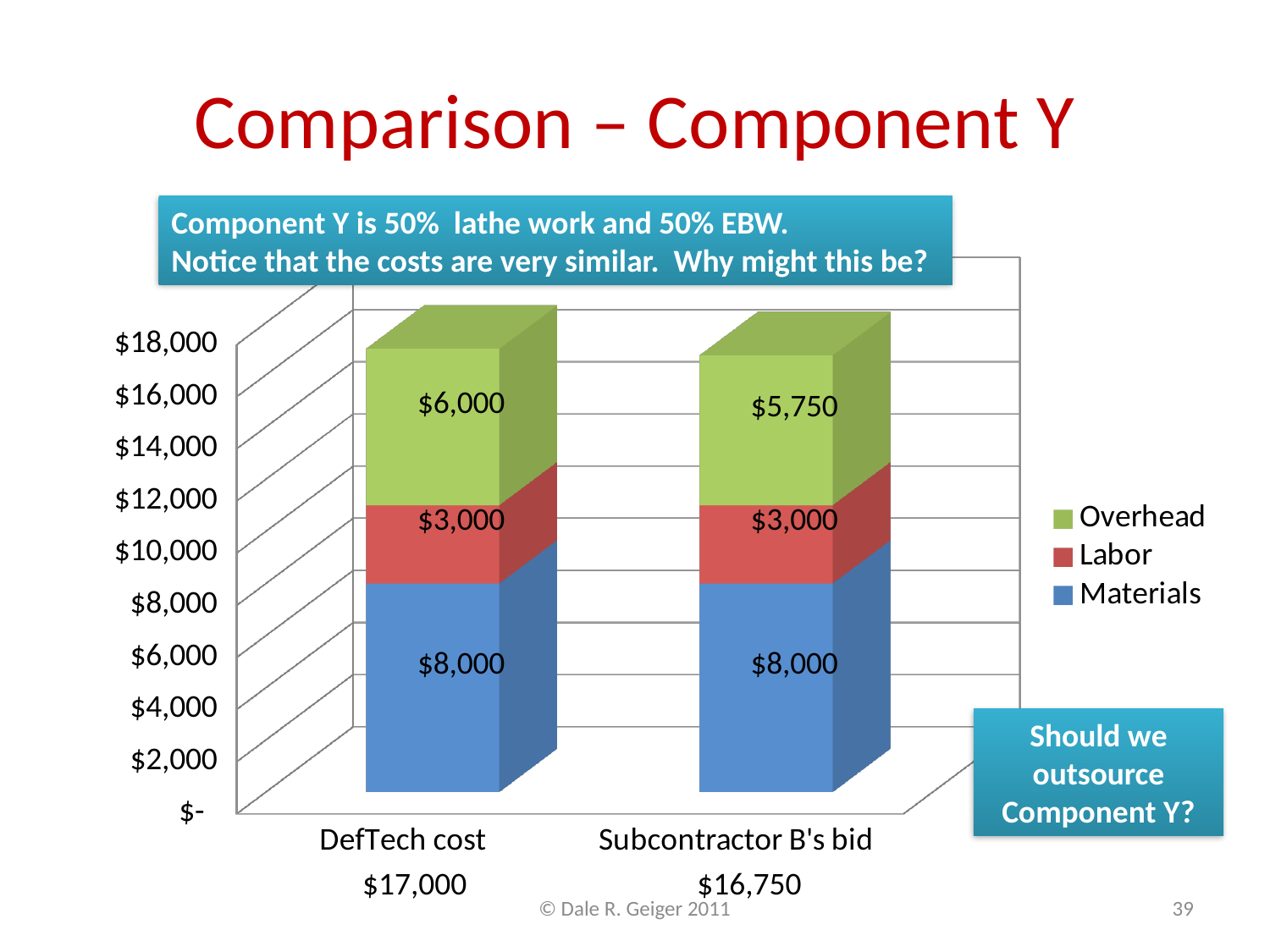
Which has the larger Overhead value, DefTech cost or Subcontractor B's bid? DefTech cost What kind of chart is shown on the slide? Stacked bar chart How many categories are shown on the x axis? 2 What is the Overhead value for Subcontractor B's bid? $5,750 What is the Overhead value for DefTech cost? $6,000 What is the total of the stacked bar for DefTech cost? $17,000 What is the total of the stacked bar for Subcontractor B's bid? $16,750 Which colour represents Materials in the chart? Blue What is the difference between the Overhead values for DefTech cost and Subcontractor B's bid? $250 What is the Labor value for DefTech cost? $3,000 How many series does the legend list? 3 What is the Materials value for Subcontractor B's bid? $8,000